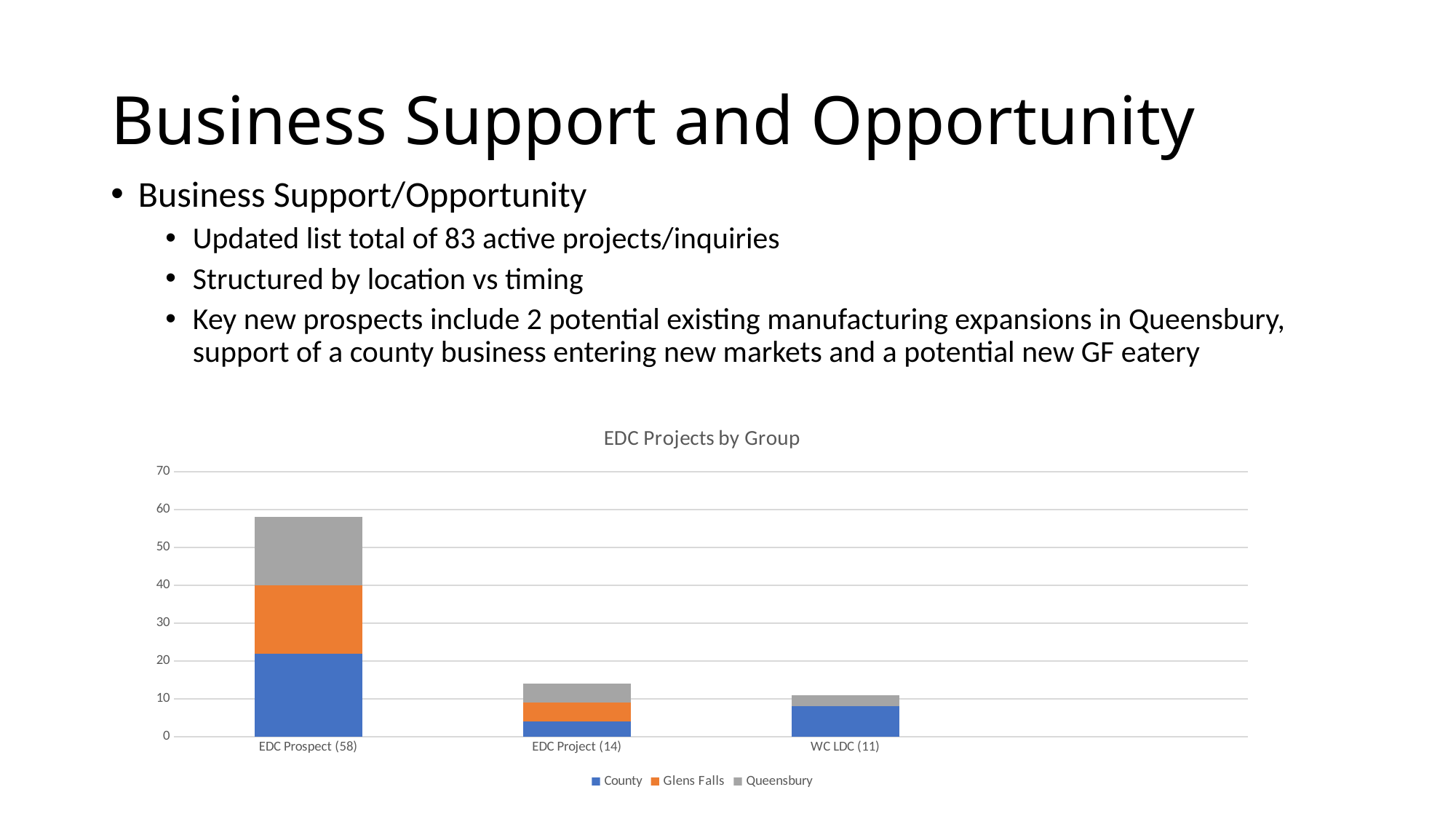
What kind of chart is shown on the slide? stacked bar chart Which series is shown in blue in the chart legend? County What is the difference between the totals for EDC Prospect and EDC Project? 44 What is the total of the stacked bar for EDC Prospect? 58 How many categories are shown on the x axis of the chart? 3 What is the total of the stacked bar for WC LDC? 11 How many series does the chart legend list? 3 What is the title of the chart? EDC Projects by Group What is the total of the stacked bar for EDC Project? 14 Is the County value for EDC Prospect greater or less than 10? greater Which category has the lowest total in the chart? WC LDC (11) Which category has the highest total in the chart? EDC Prospect (58)